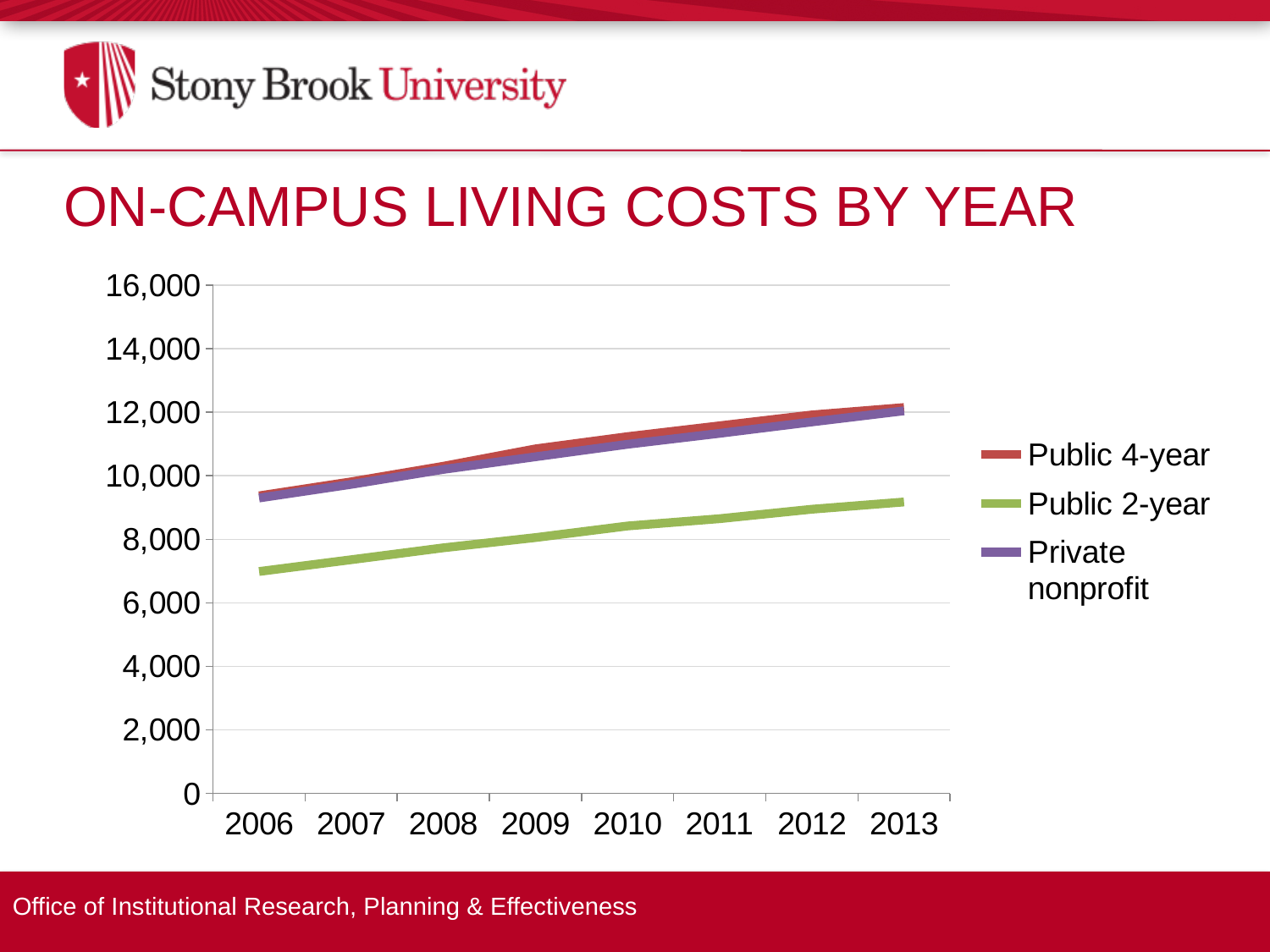
Is the value for Public 2-year in 2011 greater or less than 8,000? greater What is the title of the chart? ON-CAMPUS LIVING COSTS BY YEAR How many series does the legend list? 3 Is the value for Public 2-year in 2013 greater or less than 10,000? less Do the Public 2-year costs rise or fall from 2006 to 2013? Rise Is the value for Public 4-year in 2013 greater or less than 10,000? greater Which series has the lowest on-campus living costs across all years? Public 2-year What kind of chart is shown on the slide? Line chart Do the Public 4-year costs rise or fall over the years shown? Rise How many years are shown on the x axis? 8 In 2013, which is larger: the Public 4-year value or the Public 2-year value? Public 4-year